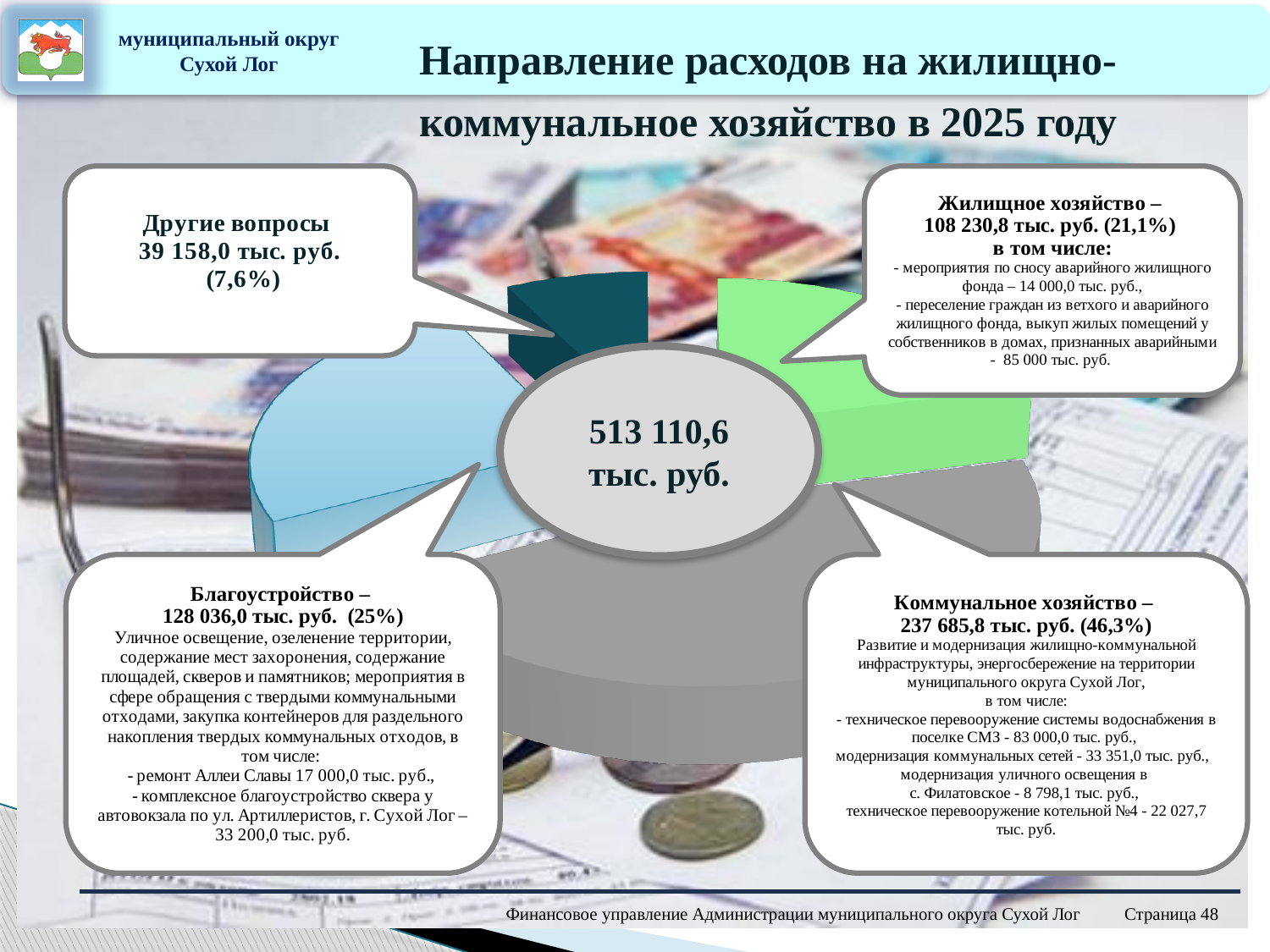
What share of the pie does Жилищное хозяйство represent? 21,1% What is the value for Коммунальное хозяйство? 237 685,8 тыс. руб. Which is larger, Благоустройство or Жилищное хозяйство? Благоустройство What is the value for Жилищное хозяйство? 108 230,8 тыс. руб. What is the value for Благоустройство? 128 036,0 тыс. руб. How many categories of expenditure does the pie chart show? 4 Which category has the smallest share of the pie? Другие вопросы What is the total amount shown in the centre of the pie chart? 513 110,6 тыс. руб. What share of the pie does Благоустройство represent? 25% Which category has the largest share of the pie? Коммунальное хозяйство What is the value for Другие вопросы? 39 158,0 тыс. руб. What kind of chart is shown on the slide? pie chart